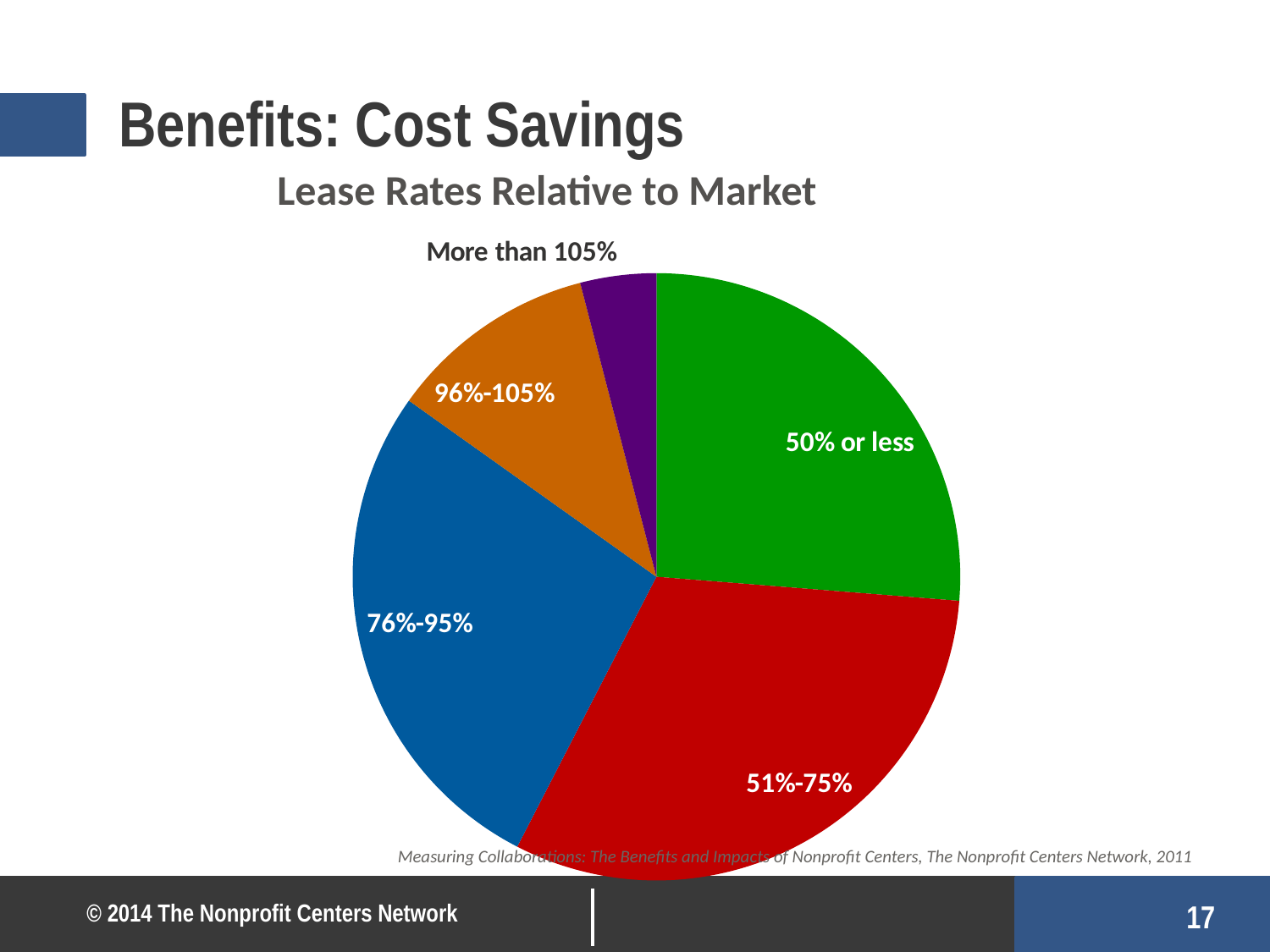
What kind of chart is shown on the slide? pie chart What colour is the slice labelled 50% or less? green What is the title of the pie chart? Lease Rates Relative to Market Which slice is larger: 96%-105% or More than 105%? 96%-105% How many slices does the pie chart have? 5 Which category has the smallest slice of the pie? More than 105% Which category has the largest slice of the pie? 51%-75% Which slice is larger: 76%-95% or More than 105%? 76%-95% Which slice is larger: 51%-75% or 96%-105%? 51%-75%